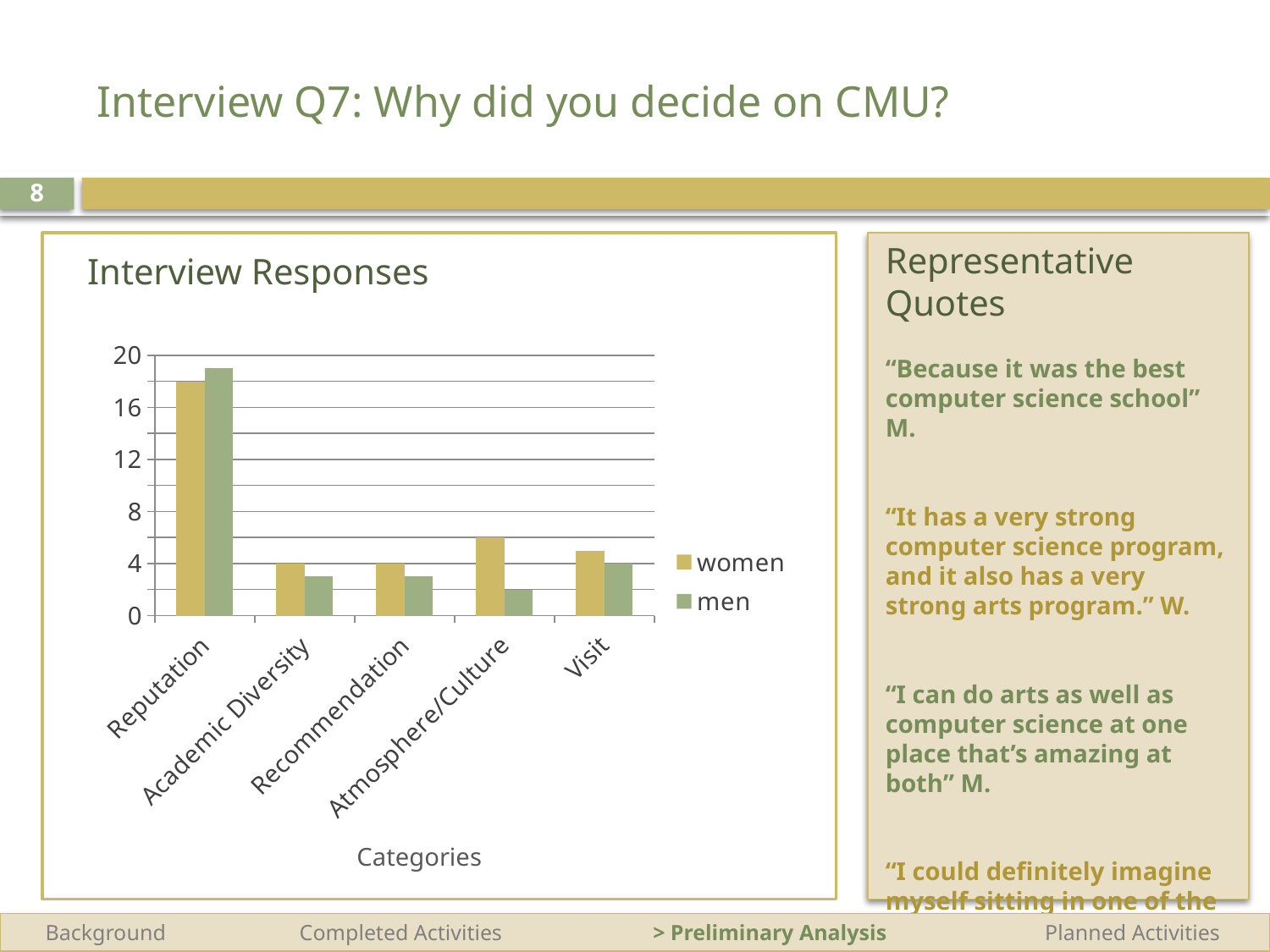
What are the two legend entries in the "Interview Responses" chart? women and men Is the value for women in the Reputation category greater or less than 16? greater Which category has the highest value for men in the "Interview Responses" chart? Reputation Which category has the highest value for women in the "Interview Responses" chart? Reputation How many categories are shown on the x axis of the "Interview Responses" chart? 5 What type of chart is shown under the title "Interview Responses"? bar chart How many series does the legend of the "Interview Responses" chart list? 2 Is the value for women in the Atmosphere/Culture category greater or less than 4? greater Which category has the lowest value for men in the "Interview Responses" chart? Atmosphere/Culture Is the value for men in the Atmosphere/Culture category greater or less than 4? less What is the title of the x axis in the "Interview Responses" chart? Categories In the Atmosphere/Culture category, which series has the larger value, women or men? women